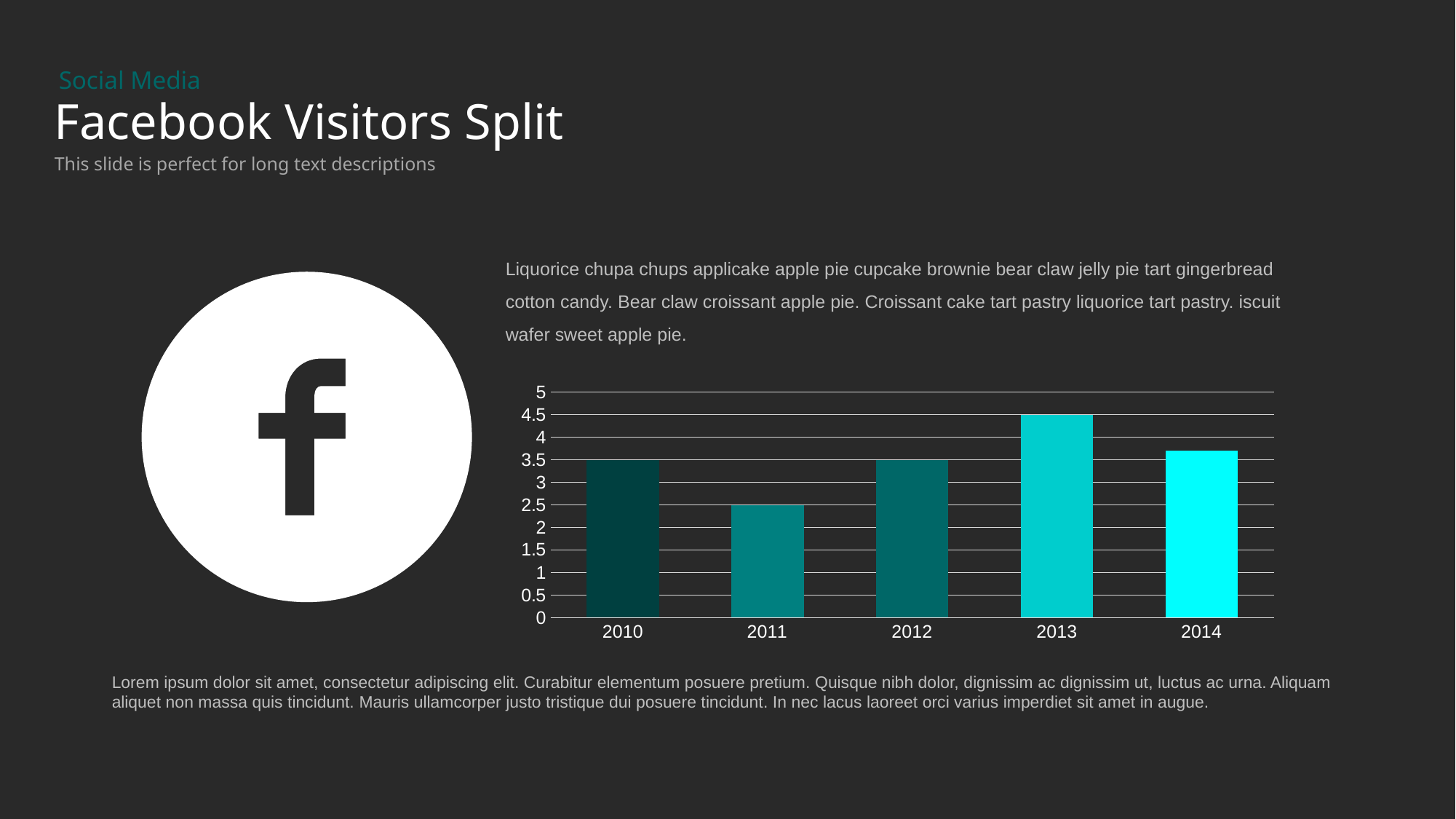
What is the value for 2010? 3.5 What type of chart is shown on the slide? bar chart What is the title of the slide containing the chart? Facebook Visitors Split What is the value for 2011? 2.5 What is the value for 2013? 4.5 Which year has the larger value, 2013 or 2014? 2013 How many years are shown on the x axis of the chart? 5 Do the values rise or fall from 2011 to 2013? rise Is the value for 2014 greater or less than 4? less Which year has the lowest value? 2011 Which year has the highest value? 2013 What is the difference between the values for 2013 and 2011? 2